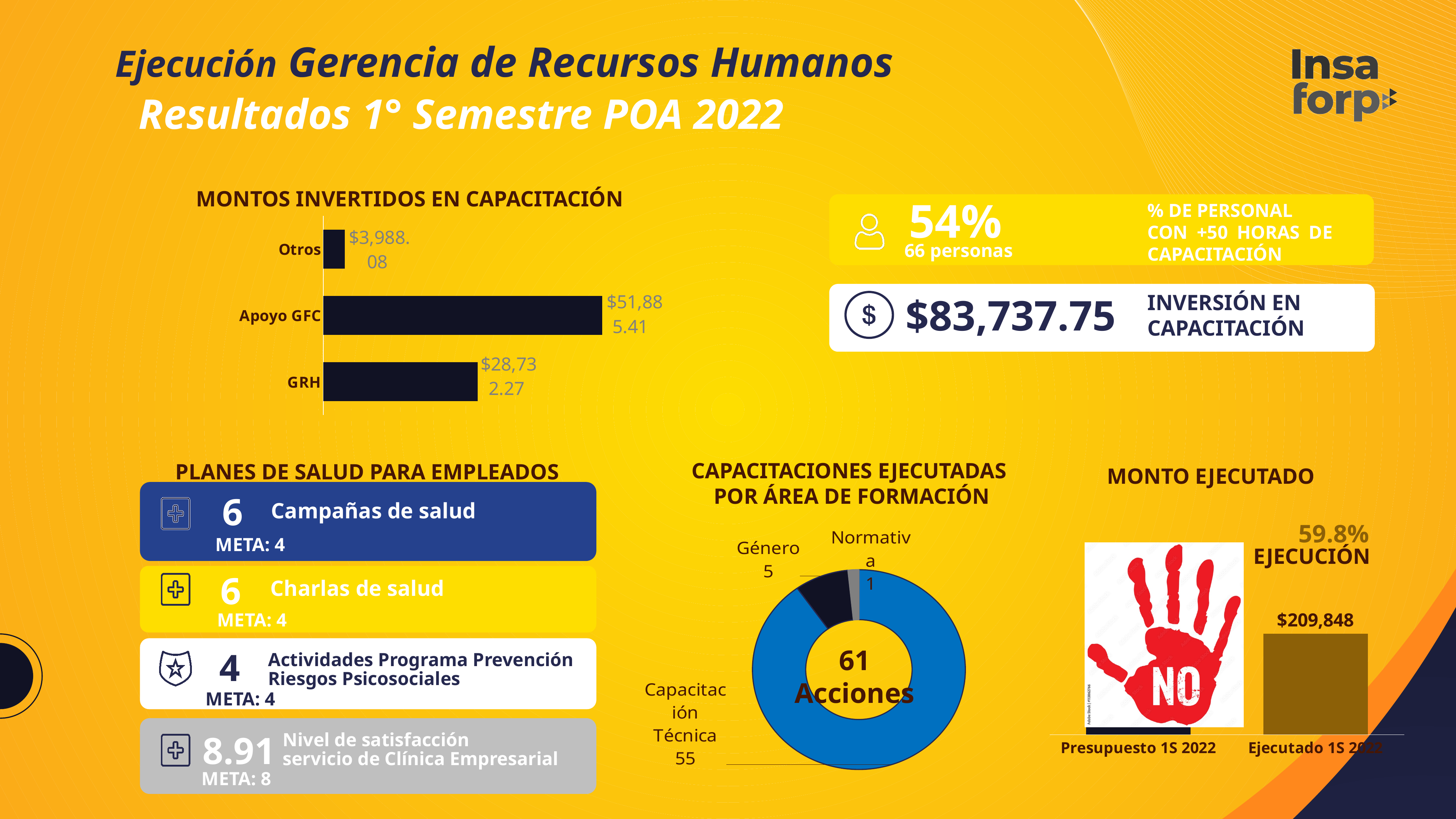
In the 'MONTOS INVERTIDOS EN CAPACITACIÓN' chart, which category has the highest amount? Apoyo GFC In the 'CAPACITACIONES EJECUTADAS POR ÁREA DE FORMACIÓN' chart, how many actions correspond to Capacitación Técnica? 55 In the 'MONTOS INVERTIDOS EN CAPACITACIÓN' chart, what is the value for Apoyo GFC? $51,885.41 In the 'MONTO EJECUTADO' chart, what is the value for Ejecutado 1S 2022? $209,848 In the 'MONTOS INVERTIDOS EN CAPACITACIÓN' chart, what is the value for Otros? $3,988.08 In the 'MONTOS INVERTIDOS EN CAPACITACIÓN' chart, how much larger is the Apoyo GFC amount than the GRH amount? $23,153.14 In the 'CAPACITACIONES EJECUTADAS POR ÁREA DE FORMACIÓN' chart, which area has the fewest actions? Normativa What kind of chart is 'MONTOS INVERTIDOS EN CAPACITACIÓN'? Bar chart In the 'MONTOS INVERTIDOS EN CAPACITACIÓN' chart, which category has the lowest amount? Otros In the 'CAPACITACIONES EJECUTADAS POR ÁREA DE FORMACIÓN' chart, what is the total number of actions shown in the centre? 61 Acciones How many categories are shown in the 'MONTOS INVERTIDOS EN CAPACITACIÓN' chart? 3 In the 'MONTOS INVERTIDOS EN CAPACITACIÓN' chart, what is the value for GRH? $28,732.27